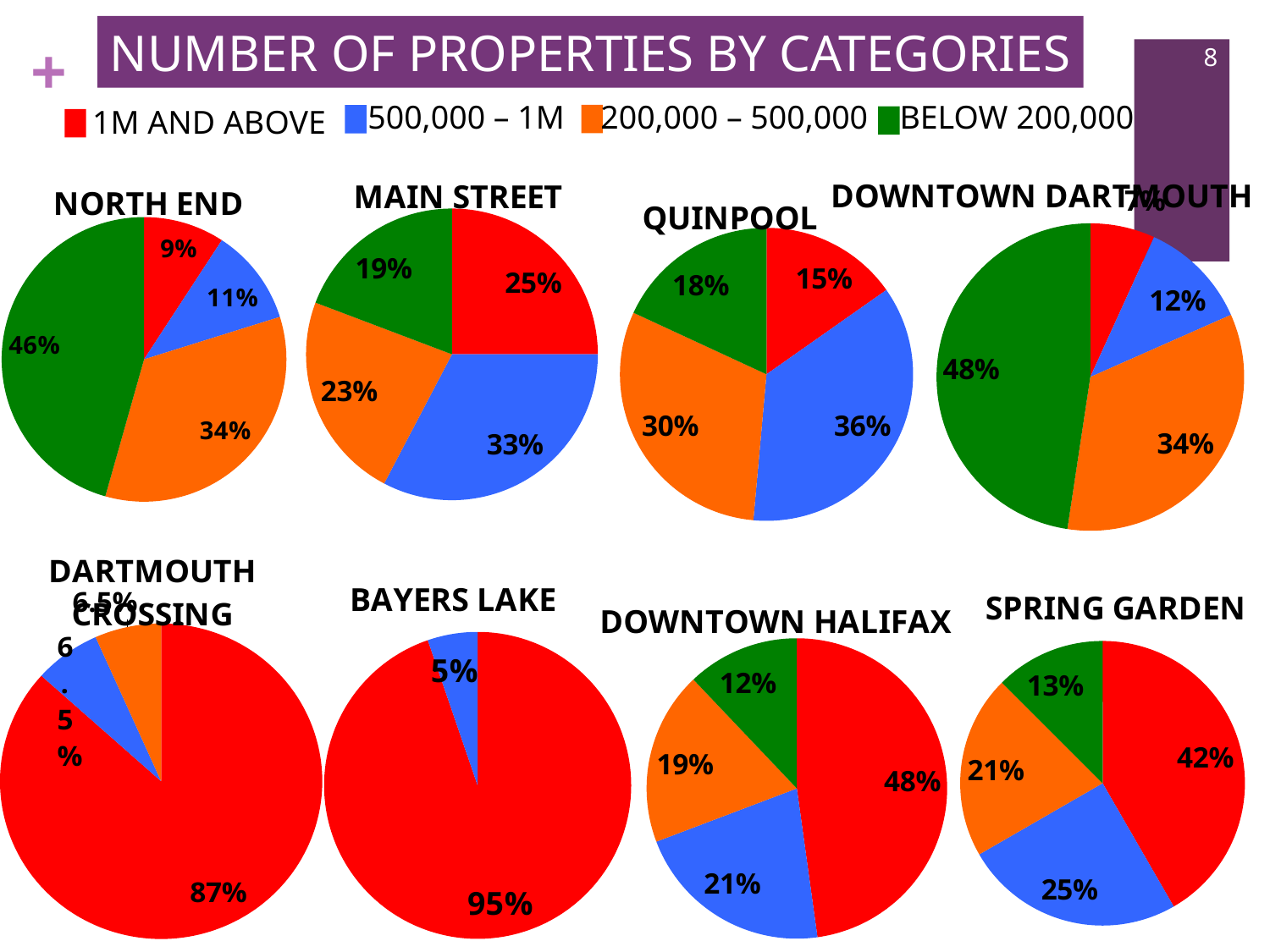
What type of chart is used for Main Street? Pie chart How many pie charts are shown on the slide? 8 In the Quinpool pie chart, what share of properties is in the 200,000 – 500,000 category? 30% In the Quinpool pie chart, which is larger: the 1M AND ABOVE share or the BELOW 200,000 share? BELOW 200,000 In the Downtown Dartmouth pie chart, which category has the largest share? BELOW 200,000 Which colour represents the 200,000 – 500,000 category in the legend? Orange In the Downtown Halifax pie chart, which category has the smallest share? BELOW 200,000 In the North End pie chart, what share of properties is in the BELOW 200,000 category? 46% In the Spring Garden pie chart, what is the difference between the 1M AND ABOVE share and the 500,000 – 1M share? 17% In the Main Street pie chart, what share of properties is in the 500,000 – 1M category? 33% How many categories does the legend list? 4